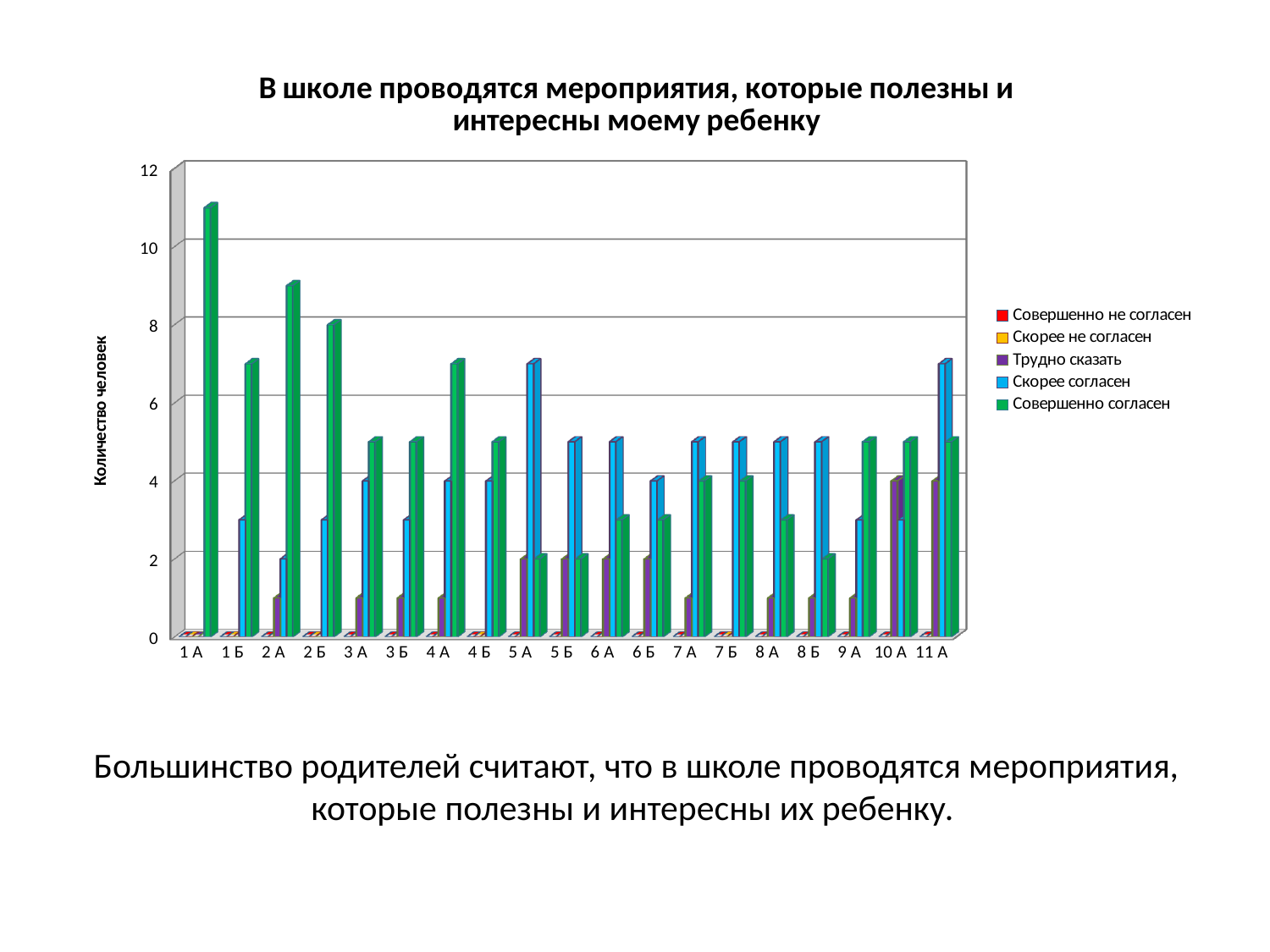
How many class categories are shown on the x axis? 19 What kind of chart is shown on the slide? bar chart Is the value for "Совершенно согласен" in class 6 Б greater or less than 4? less What is the label of the vertical axis? Количество человек Which is larger: "Совершенно согласен" for class 1 А or for class 1 Б? 1 А How many series does the legend list? 5 Is the value for "Трудно сказать" in class 10 А greater or less than 2? greater Is the value for "Совершенно согласен" in class 2 А greater or less than 8? greater Which class has the tallest bar in the chart? 1 А In class 5 А, which series has the larger value: "Скорее согласен" or "Совершенно согласен"? Скорее согласен